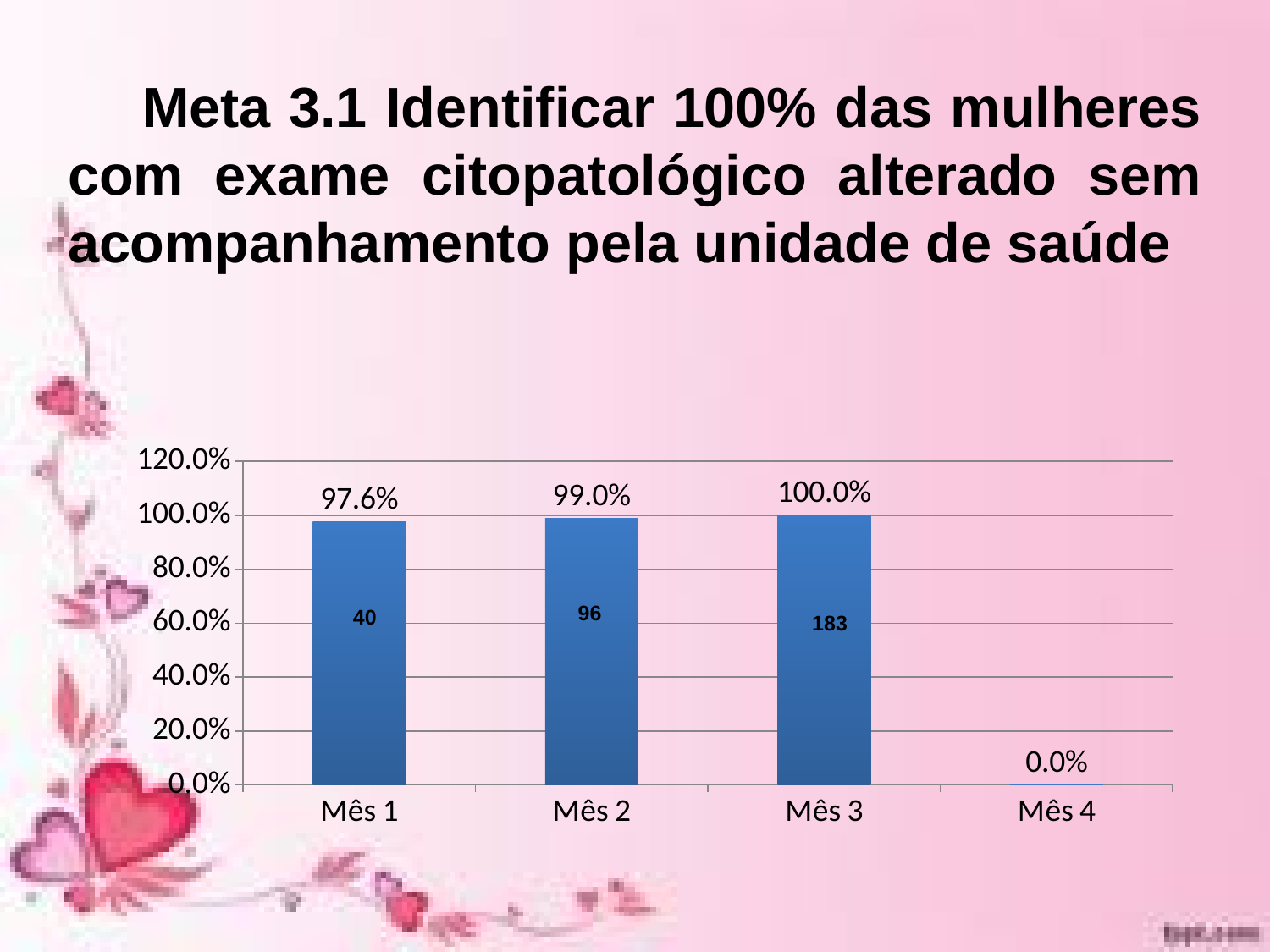
What is the value for Mês 4? 0.0% Which month has the lowest value? Mês 4 Which is larger, the value for Mês 2 or the value for Mês 1? Mês 2 Which month has the highest value? Mês 3 What is the value for Mês 1? 97.6% What is the value for Mês 2? 99.0% How many months are shown on the x axis? 4 What is the difference between the values for Mês 3 and Mês 1? 2.4% What is the value for Mês 3? 100.0% What number is printed inside the bar for Mês 3? 183 Do the values rise or fall from Mês 1 to Mês 3? Rise What kind of chart is shown on the slide? Bar chart